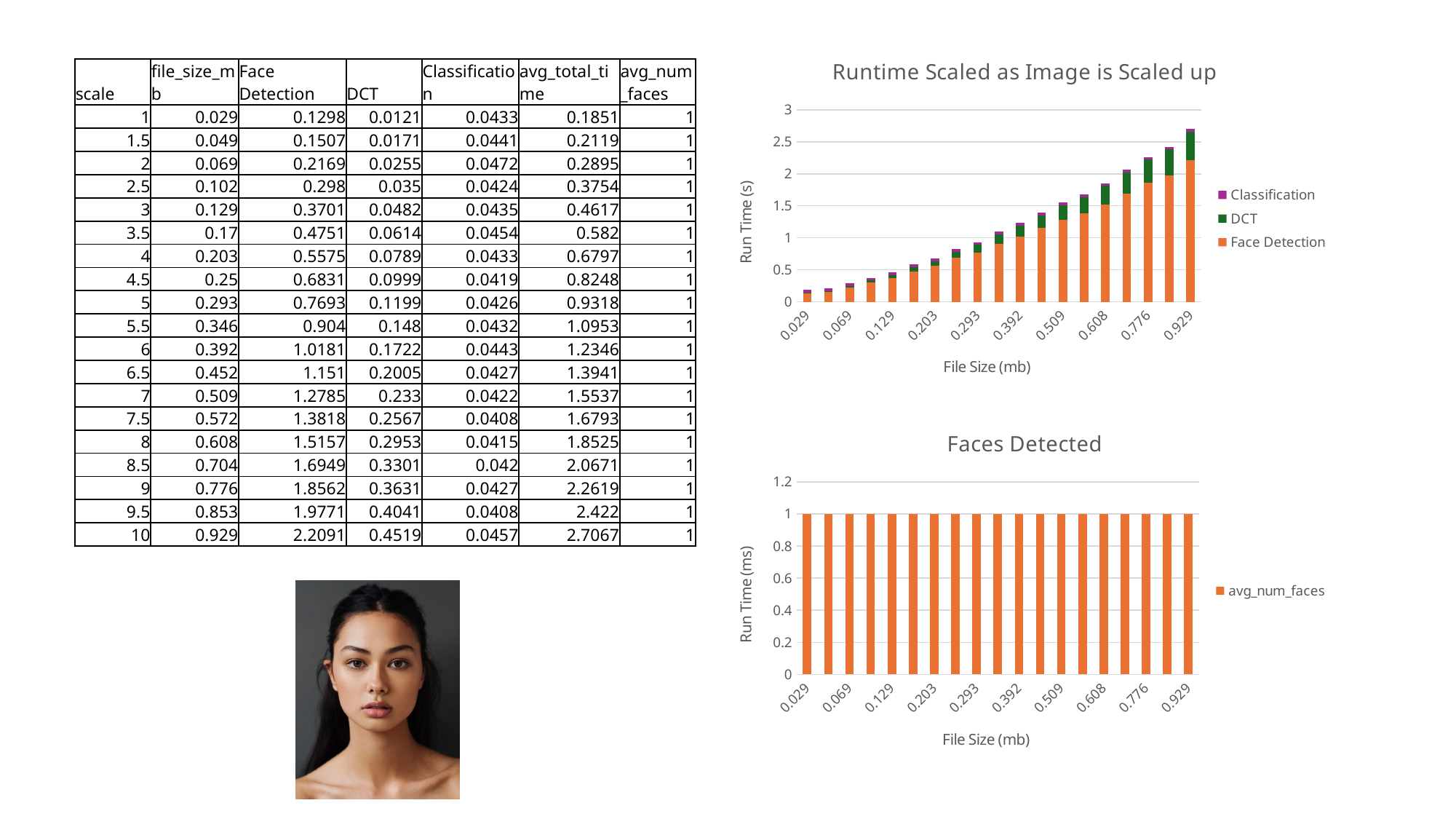
How many series does the legend of the 'Faces Detected' chart list? 1 In the 'Runtime Scaled as Image is Scaled up' chart, is the total run time for file size 0.029 greater or less than 0.5? less In the 'Faces Detected' chart, what is the avg_num_faces value for file size 0.029? 1 In the 'Runtime Scaled as Image is Scaled up' chart, does the total run time rise or fall as file size increases along the x axis? rise What kind of chart is the 'Runtime Scaled as Image is Scaled up' chart? Stacked bar chart In the 'Runtime Scaled as Image is Scaled up' chart, is the Face Detection value for file size 0.776 greater or less than 1.5? greater How many series does the legend of the 'Runtime Scaled as Image is Scaled up' chart list? 3 In the 'Runtime Scaled as Image is Scaled up' chart, which file size has the lowest total run time? 0.029 What is the x-axis label of the 'Runtime Scaled as Image is Scaled up' chart? File Size (mb) In the 'Runtime Scaled as Image is Scaled up' chart, is the total run time for file size 0.929 greater or less than 2.5? greater In the 'Runtime Scaled as Image is Scaled up' chart, which file size has the highest total run time? 0.929 How many bars are plotted in the 'Faces Detected' chart? 19